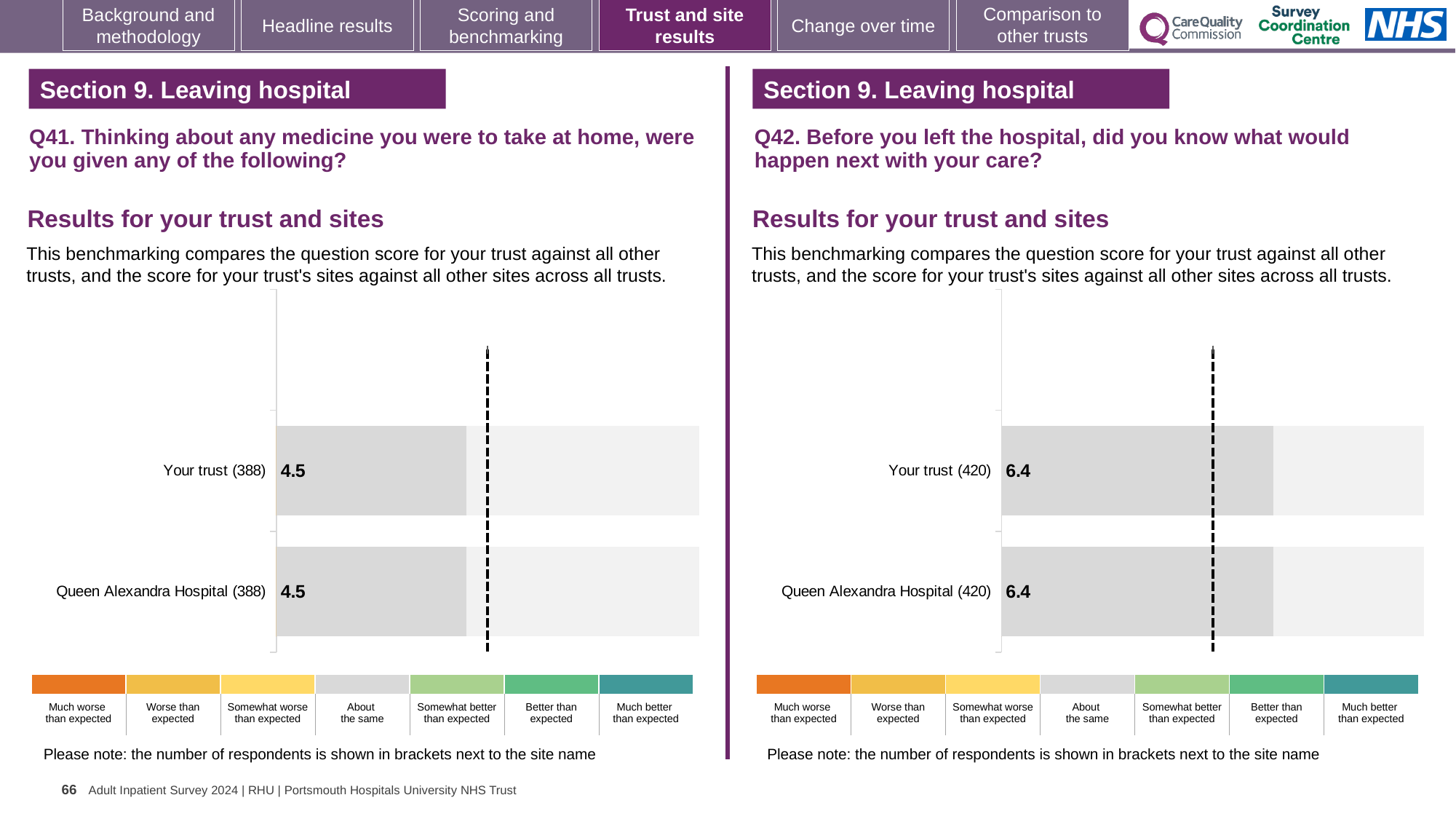
On the Q42 chart (right), how many respondents are shown in brackets for Queen Alexandra Hospital? 420 How many categories does the colour key below the Q41 chart (left) list? 7 On the Q41 chart (left), what is the score for Queen Alexandra Hospital? 4.5 On the Q41 chart (left), what is the score for Your trust? 4.5 On the Q42 chart (right), what is the difference between the score for Your trust and the score for Queen Alexandra Hospital? 0.0 On the Q41 chart (left), how many bars are plotted? 2 On the Q42 chart (right), which benchmark category does the grey colour of the bars correspond to in the colour key? About the same On the Q42 chart (right), what is the score for Queen Alexandra Hospital? 6.4 On the Q41 chart (left), how many respondents are shown in brackets for Your trust? 388 On the Q42 chart (right), how many bars are plotted? 2 What kind of chart is used on the Q41 chart (left)? Bar chart On the Q42 chart (right), what is the score for Your trust? 6.4